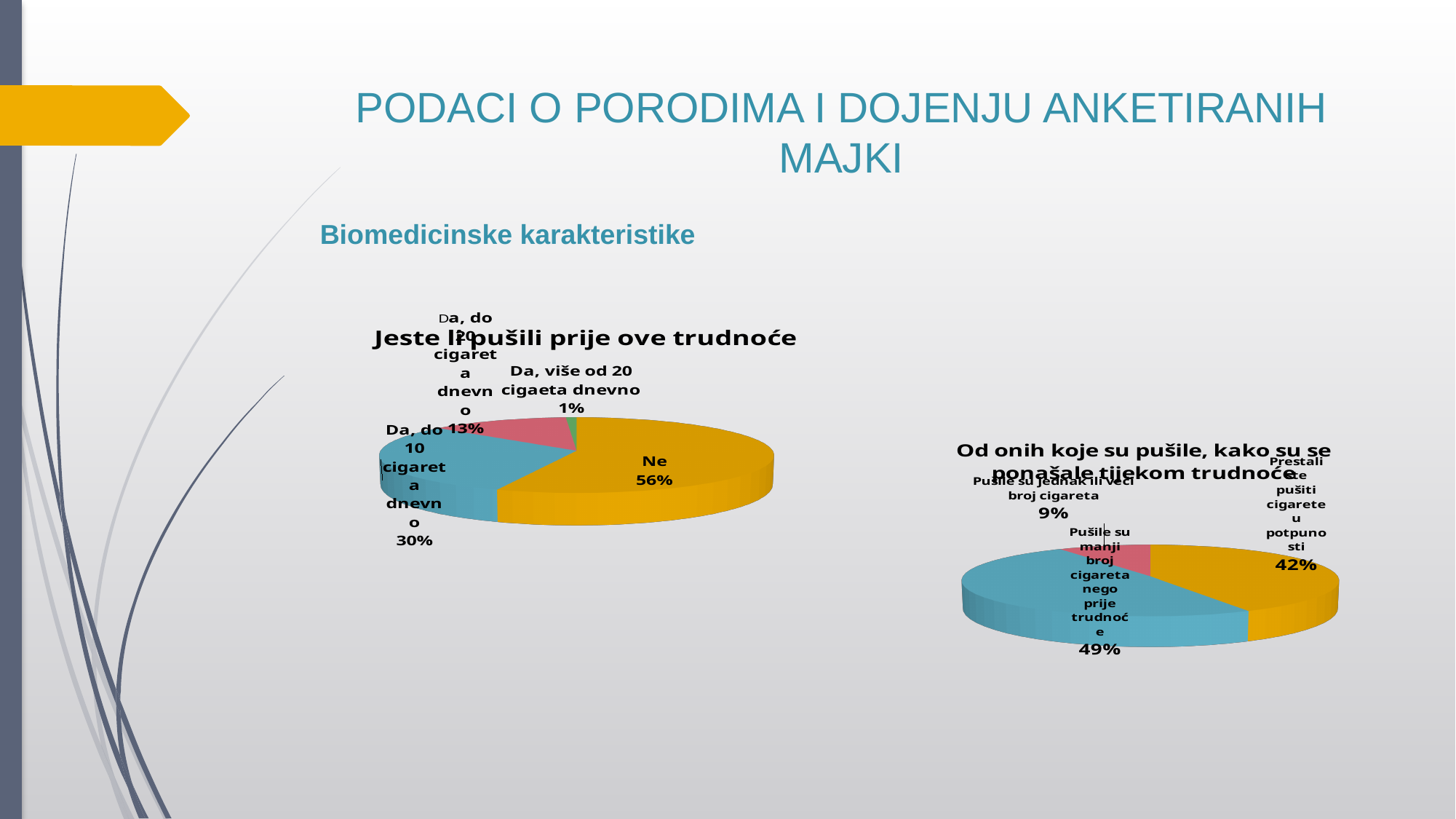
In the right chart "Od onih koje su pušile, kako su se ponašale tijekom trudnoće", which slice is the largest? Pušile su manji broj cigareta nego prije trudnoće In the left chart "Jeste li pušili prije ove trudnoće", which slice is the smallest? Da, više od 20 cigaeta dnevno In the left chart "Jeste li pušili prije ove trudnoće", what share is labelled "Da, do 10 cigareta dnevno"? 30% In the left chart "Jeste li pušili prije ove trudnoće", how many slices does the pie have? 4 In the right chart "Od onih koje su pušile, kako su se ponašale tijekom trudnoće", how many slices does the pie have? 3 In the left chart "Jeste li pušili prije ove trudnoće", which slice is the largest? Ne In the left chart "Jeste li pušili prije ove trudnoće", what share is labelled "Ne"? 56% In the left chart "Jeste li pušili prije ove trudnoće", what is the difference between the "Ne" share and the "Da, do 10 cigareta dnevno" share? 26% In the right chart "Od onih koje su pušile, kako su se ponašale tijekom trudnoće", what share is labelled "Pušile su jednak ili veći broj cigareta"? 9% In the left chart "Jeste li pušili prije ove trudnoće", what share is labelled "Da, više od 20 cigaeta dnevno"? 1% What kind of chart is the left chart titled "Jeste li pušili prije ove trudnoće"? Pie chart In the right chart "Od onih koje su pušile, kako su se ponašale tijekom trudnoće", what share is labelled "Prestale su pušiti cigarete u potpunosti"? 42%